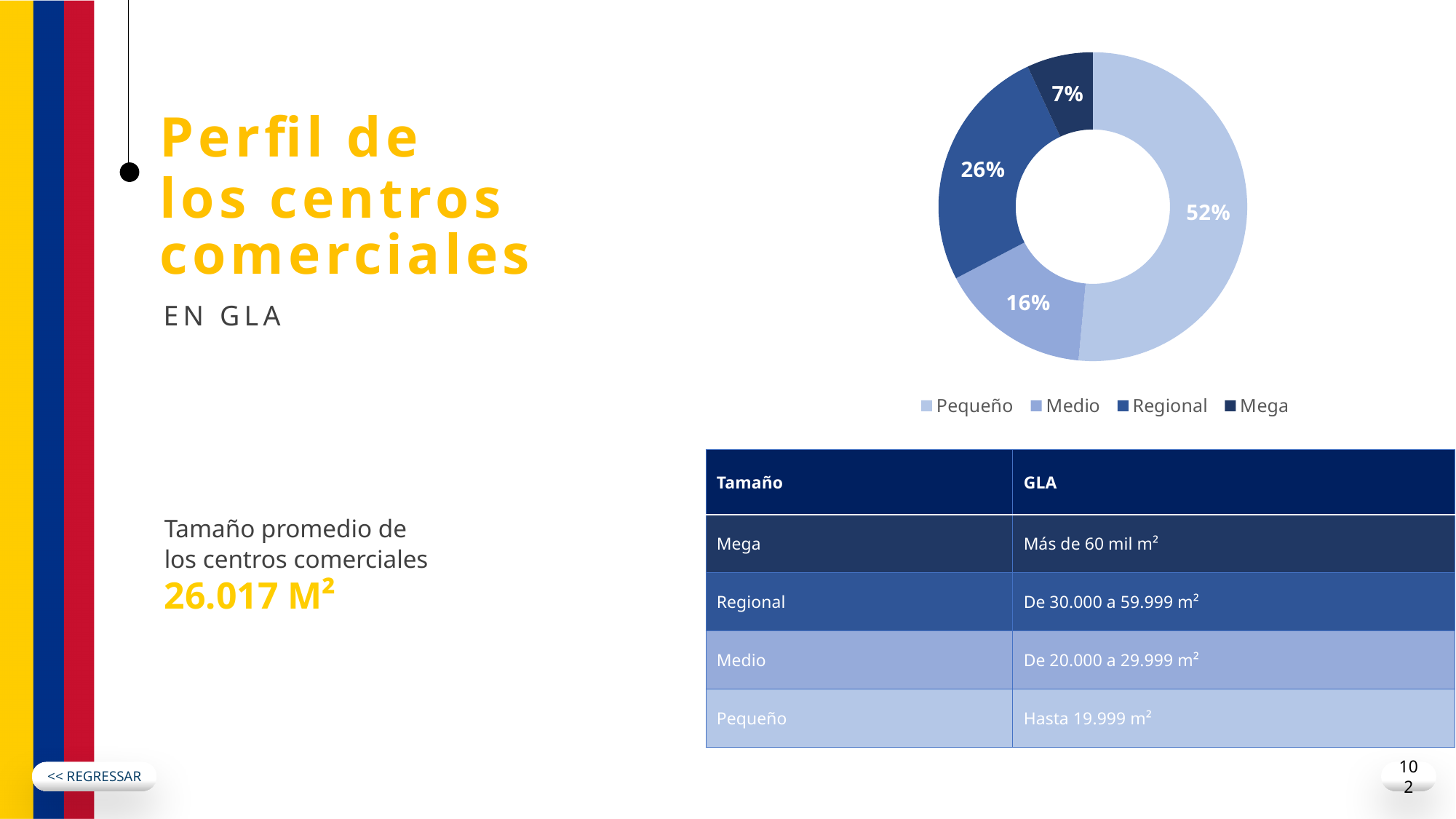
Which category has the largest share in the donut chart? Pequeño Which slice is larger, Medio or Regional? Regional How many entries does the chart legend list? 4 How many categories are shown in the donut chart? 4 What percentage is shown for the Mega slice? 7% What share of the donut chart does Pequeño represent? 52% Which legend entry is shown in the darkest blue colour? Mega What percentage is shown for the Regional slice? 26% What is the difference in percentage points between the Pequeño and Regional slices? 26 Which category has the smallest share in the donut chart? Mega What type of chart is shown on the slide? Donut (pie) chart What percentage is shown for the Medio slice? 16%